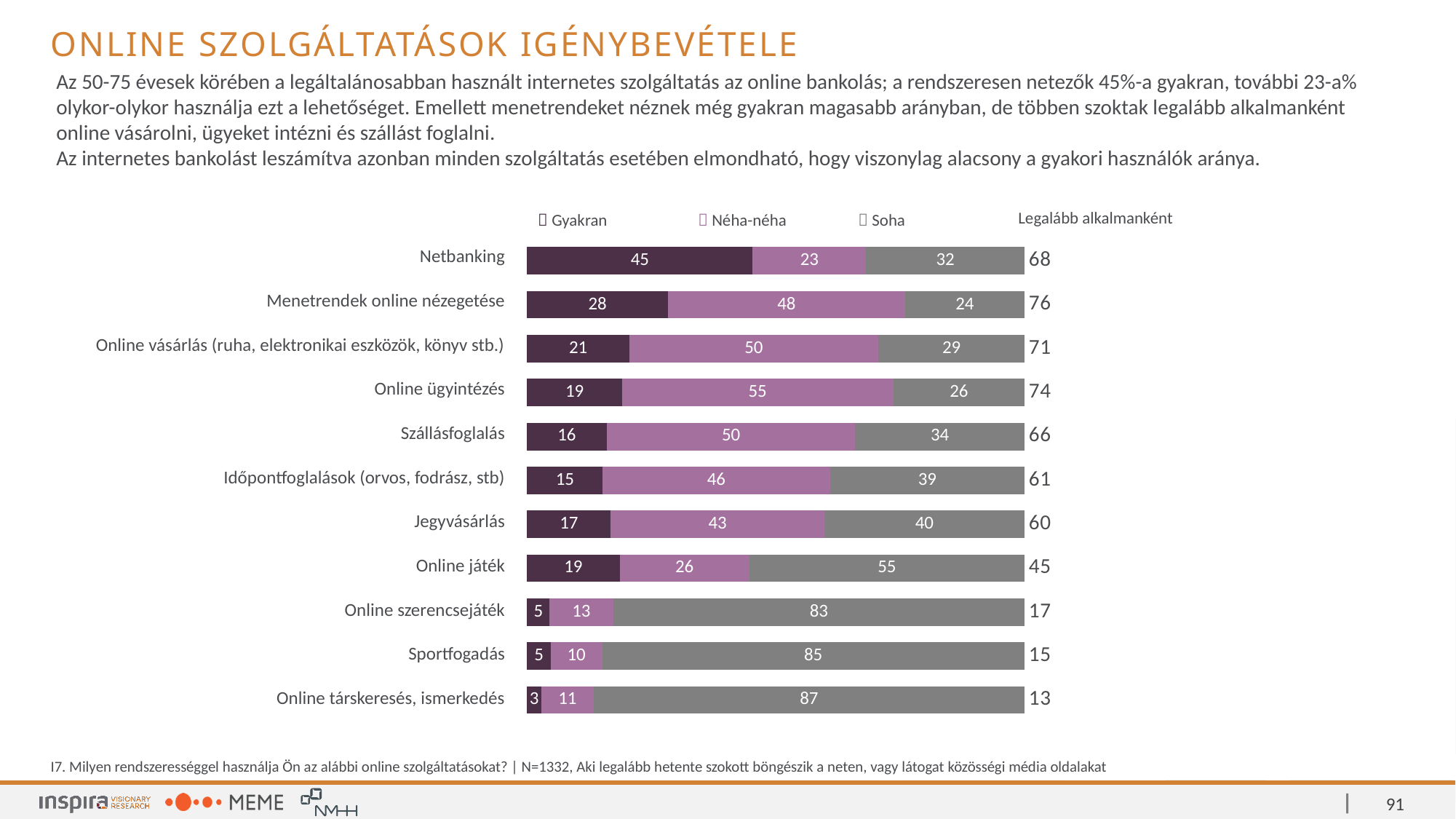
What is the Gyakran value for Netbanking? 45 Which category has the lowest Gyakran value? Online társkeresés, ismerkedés Which is larger: the Néha-néha value for Menetrendek online nézegetése or for Jegyvásárlás? Menetrendek online nézegetése What kind of chart is shown on the slide? Stacked bar chart How many series does the legend list? 3 Which category has the highest Gyakran value? Netbanking What is the total of the Gyakran and Néha-néha values for Szállásfoglalás? 66 What is the difference between the Soha values for Sportfogadás and Online játék? 30 What is the 'Legalább alkalmanként' value shown for Online szerencsejáték? 17 What is the Néha-néha value for Online ügyintézés? 55 What is the Soha value for Online társkeresés, ismerkedés? 87 How many categories are shown in the chart? 11